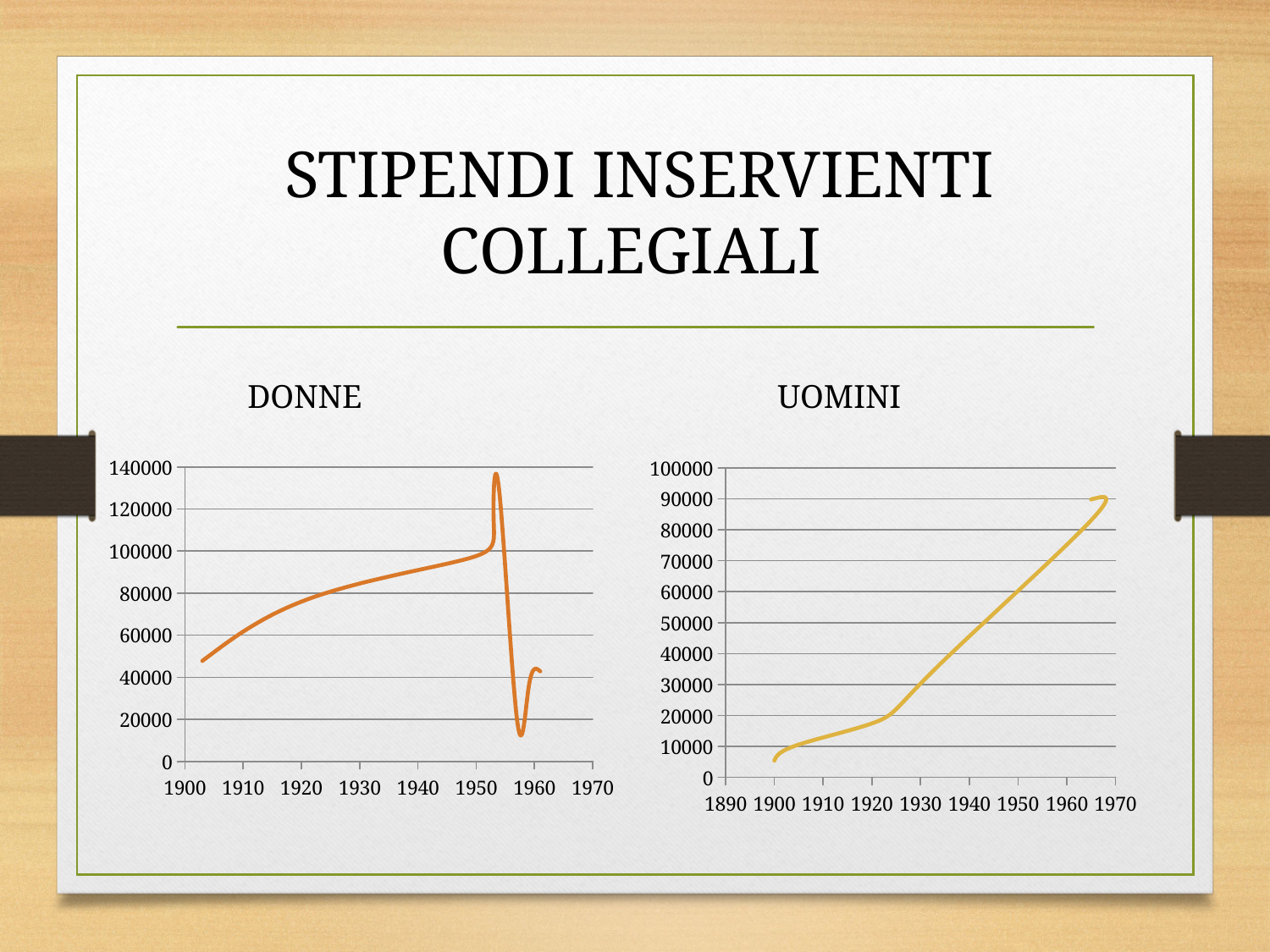
In the UOMINI chart, is the value around 1910 greater or less than 20000? less In the DONNE chart, do the values rise or fall between 1900 and 1950? rise What is the highest value shown on the vertical axis of the UOMINI chart? 100000 In the DONNE chart, is the value around 1940 greater or less than 80000? greater In the UOMINI chart, is the value around 1950 greater or less than 50000? greater What kind of chart is the UOMINI chart? line chart What kind of chart is the DONNE chart? line chart What is the highest value shown on the vertical axis of the DONNE chart? 140000 In the UOMINI chart, do the values generally rise or fall from 1900 to 1970? rise